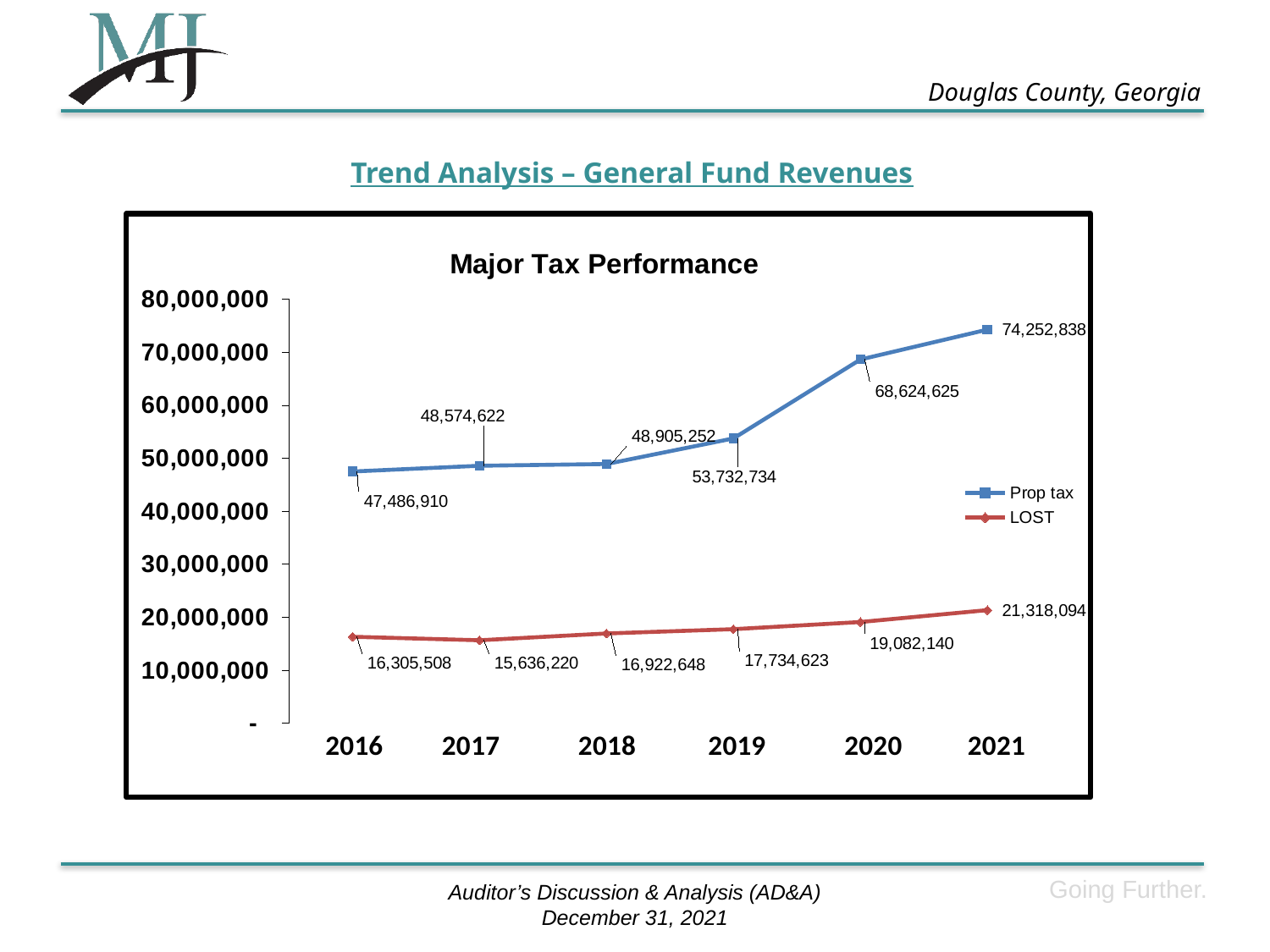
What is the title of the chart? Major Tax Performance Which is larger, the Prop tax value in 2020 or in 2019? 2020 What is the Prop tax value for 2019? 53,732,734 What is the difference between the Prop tax and LOST values in 2021? 52,934,744 In which year is the LOST value lowest? 2017 What is the LOST value for 2017? 15,636,220 What type of chart is shown on the slide? Line chart In which year is the Prop tax value highest? 2021 Does the Prop tax series rise or fall from 2016 to 2021? Rise What is the Prop tax value for 2021? 74,252,838 How many series does the legend list? 2 How many years are plotted on the x axis? 6